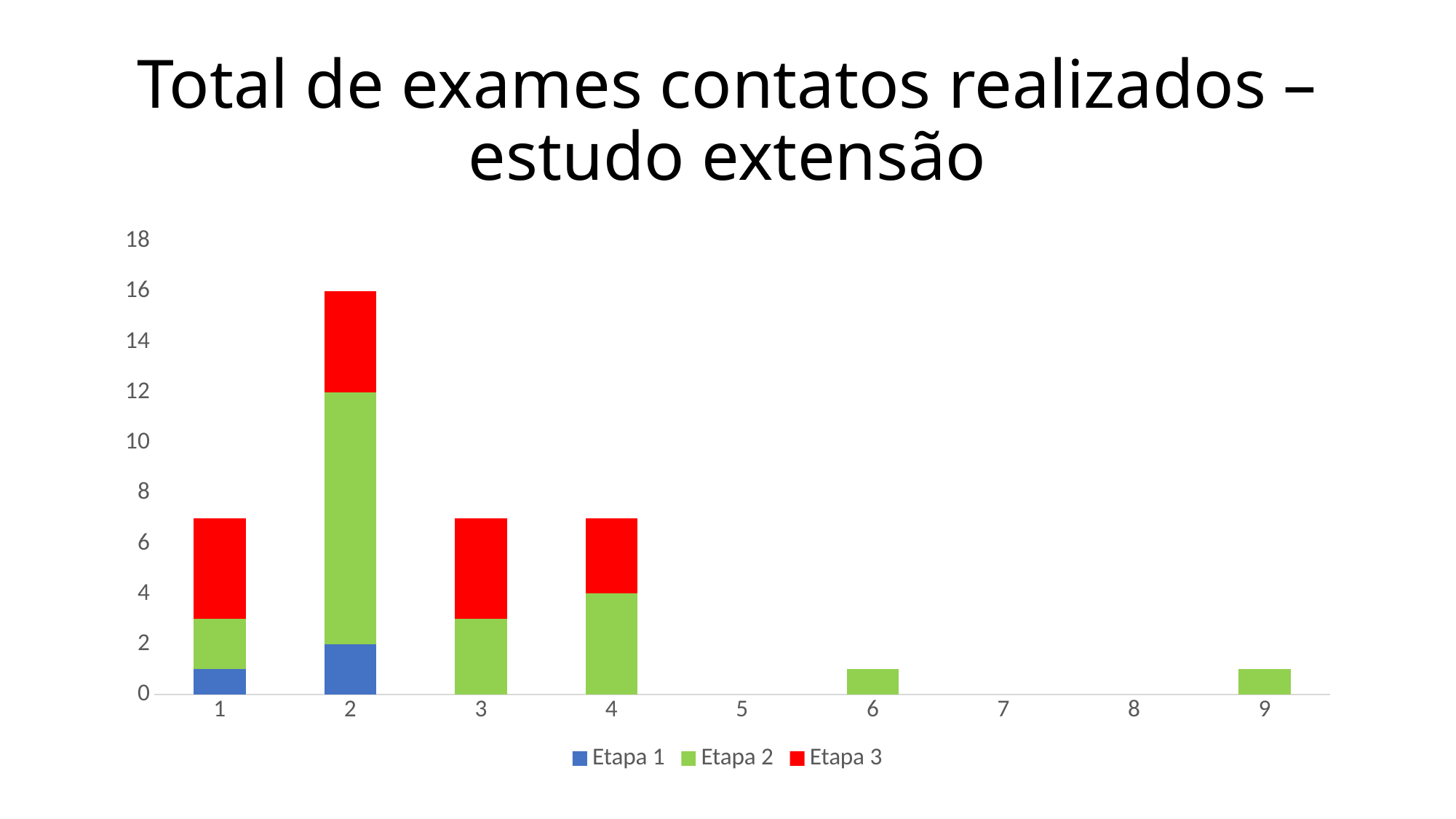
Is the total for category 1 greater or less than 6? greater Is the value for category 6 greater or less than 2? less How many categories are shown on the x axis? 9 Which categories have no bar at all? 5, 7 and 8 What is the total height of the stacked bar for category 2? 16 Is the total for category 3 greater or less than 8? less What is the value of Etapa 1 for category 2? 2 What kind of chart is shown on the slide? Stacked bar chart What are the three series names listed in the legend? Etapa 1, Etapa 2, Etapa 3 Which has the larger total bar, category 2 or category 3? Category 2 Which category has the highest total bar? 2 How many series does the legend list? 3